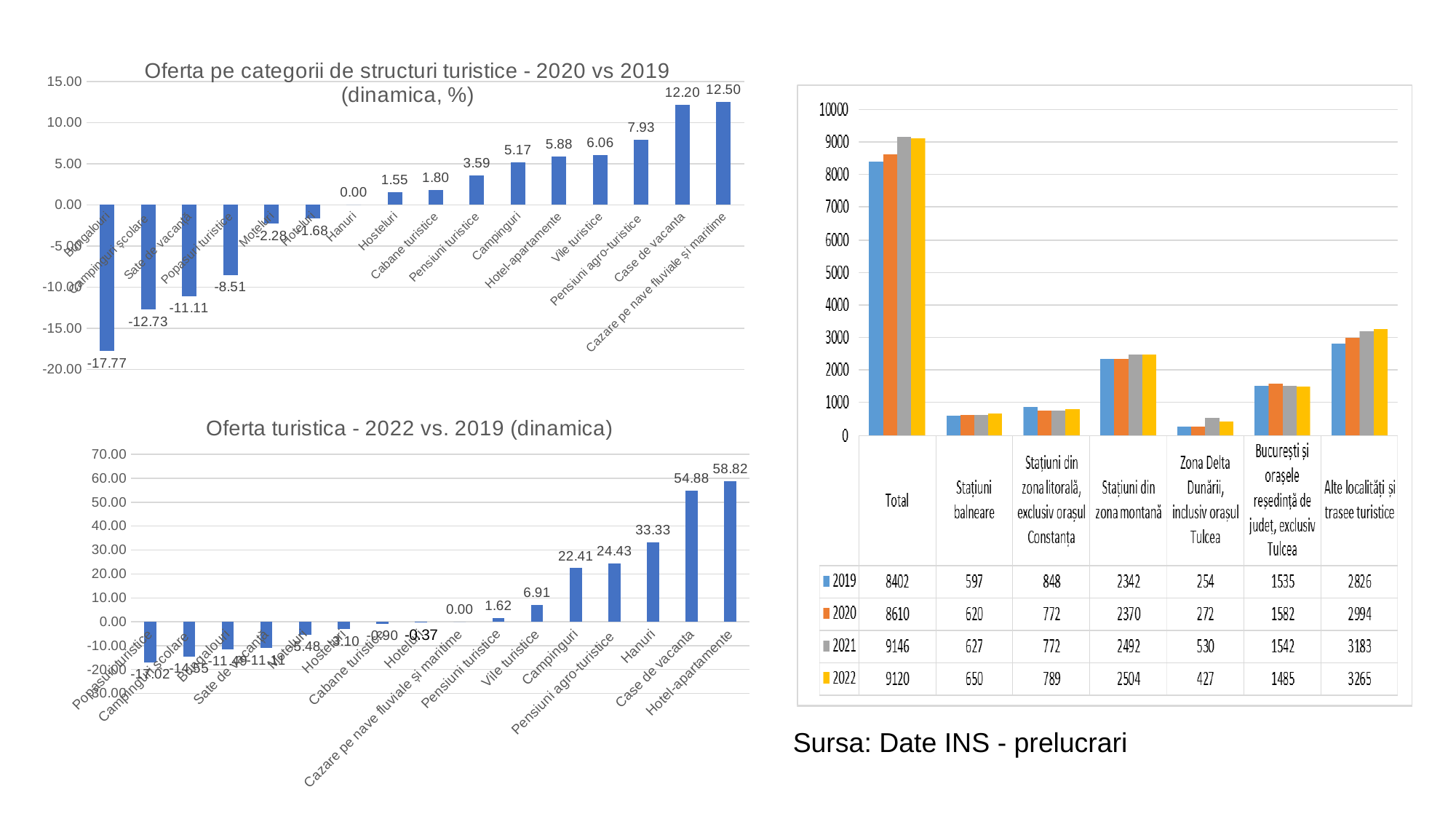
In the chart 'Oferta turistica - 2022 vs. 2019 (dinamica)', which is larger, the value for Campinguri or the value for Pensiuni agro-turistice? Pensiuni agro-turistice In the chart 'Oferta turistica - 2022 vs. 2019 (dinamica)', what is the value for Vile turistice? 6.91 In the chart on the right of the slide, what is the difference between the Total for 2022 and the Total for 2019? 718 In the chart 'Oferta pe categorii de structuri turistice - 2020 vs 2019', which category has the lowest value? Bungalouri In the chart on the right of the slide, how many series does the legend list? 4 In the chart 'Oferta pe categorii de structuri turistice - 2020 vs 2019', what is the value for Case de vacanta? 12.20 In the chart 'Oferta pe categorii de structuri turistice - 2020 vs 2019', which category has the highest value? Cazare pe nave fluviale și maritime In the chart on the right of the slide, what is the value for Stațiuni din zona montană in 2021? 2492 In the chart 'Oferta turistica - 2022 vs. 2019 (dinamica)', which category has the highest value? Hotel-apartamente What kind of chart is the chart on the right of the slide? Bar chart In the chart 'Oferta pe categorii de structuri turistice - 2020 vs 2019', what is the difference between the values for Pensiuni agro-turistice and Campinguri? 2.76 In the chart 'Oferta turistica - 2022 vs. 2019 (dinamica)', what is the value for Hanuri? 33.33